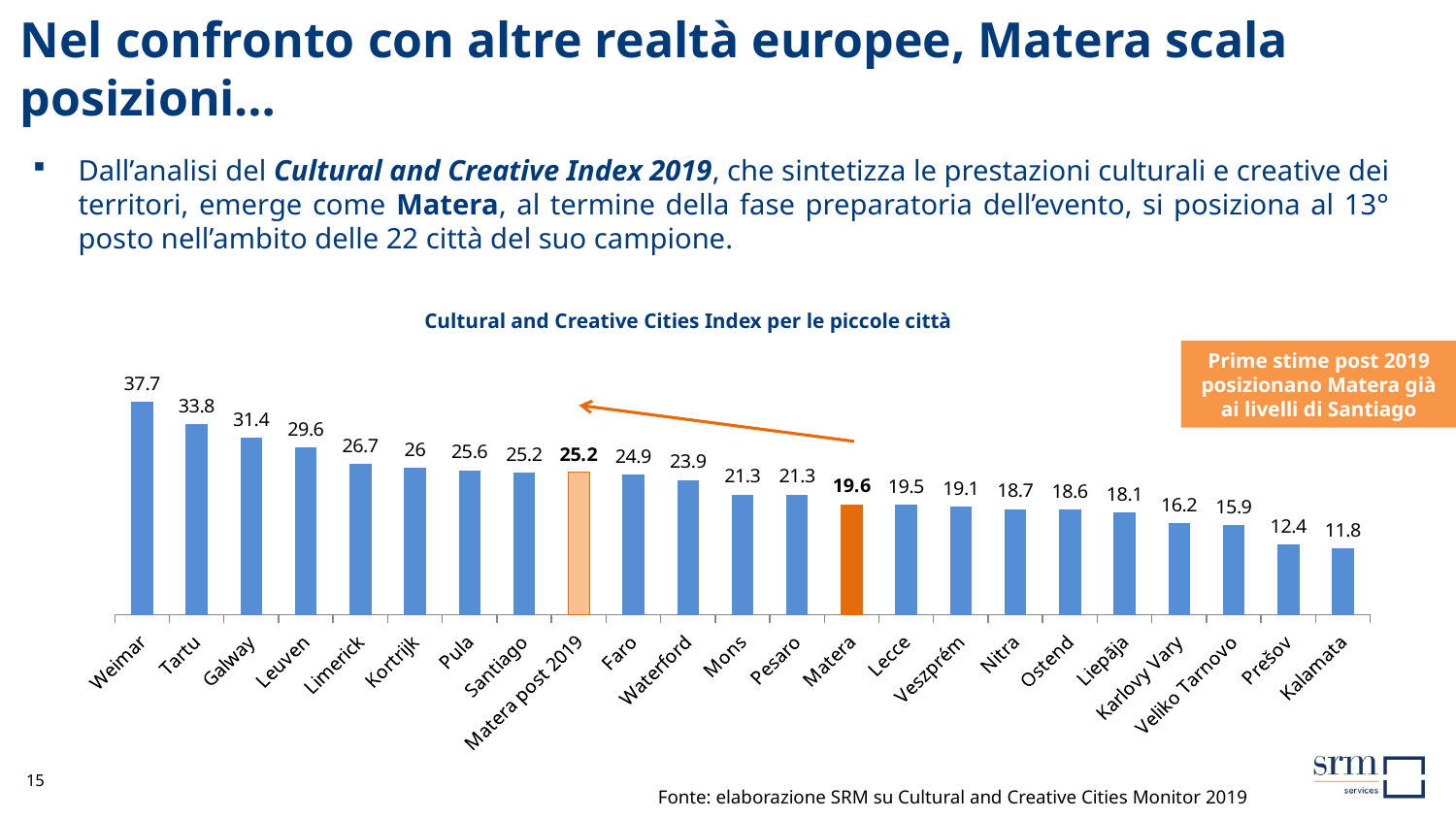
Which has a larger value, Galway or Leuven? Galway Which city has the lowest value in the chart? Kalamata What is the difference between the values for Matera post 2019 and Matera? 5.6 What is the value for Matera post 2019? 25.2 What is the difference between the values for Weimar and Tartu? 3.9 How many cities are shown in the chart? 23 Do the values rise or fall from left to right along the x axis? Fall What kind of chart is shown on the slide? Bar chart Which city has the highest value in the chart? Weimar What is the value for Weimar? 37.7 What is the value for Kalamata? 11.8 What is the value for Matera? 19.6